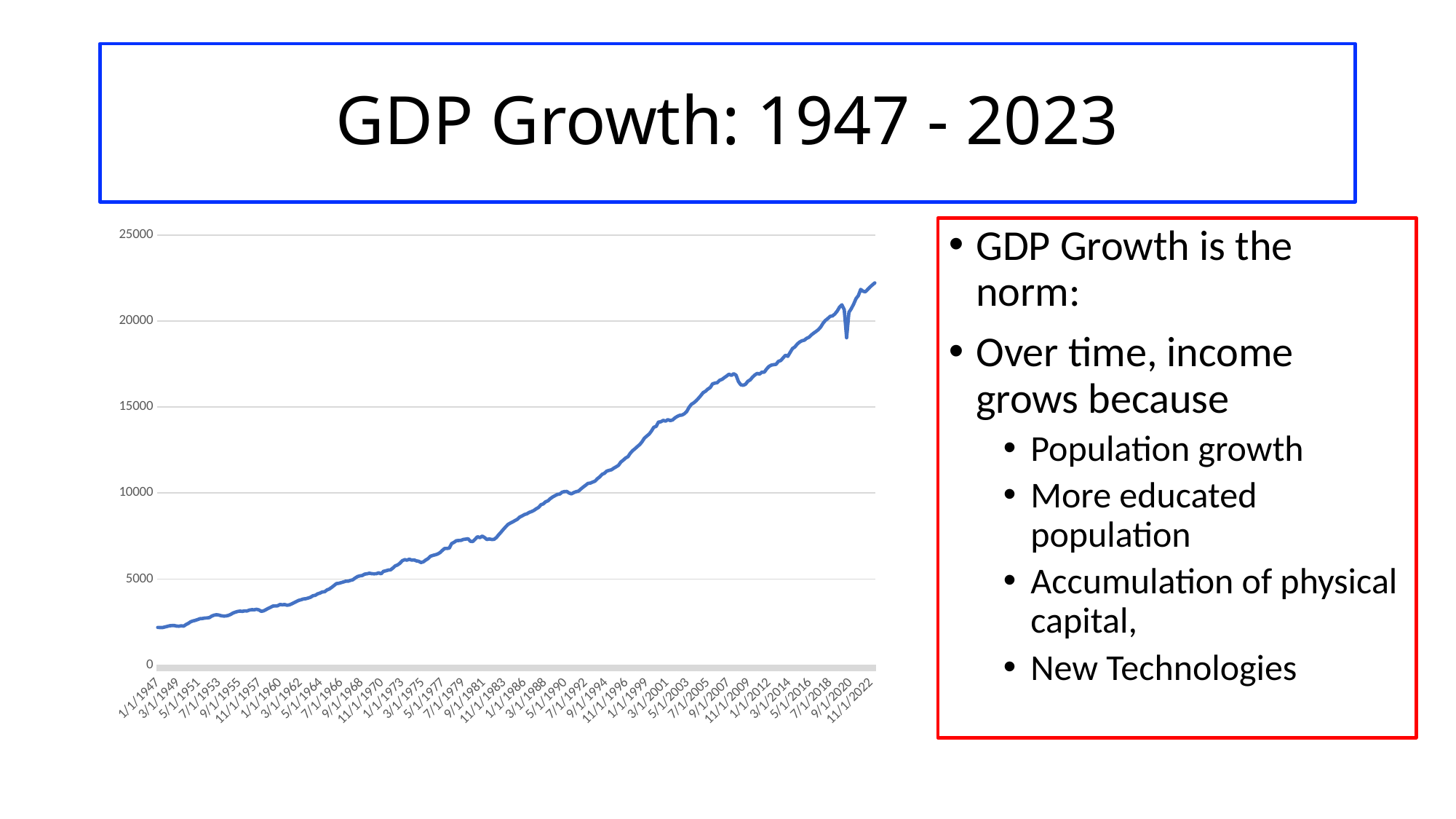
At which x-axis label is the plotted value lowest? 1/1/1947 Is the value for 9/1/1981 greater or less than 10000? less Is the value for 9/1/2007 greater or less than 15000? greater What is the highest value shown on the y axis of the chart? 25000 Is the value for 11/1/2022 greater or less than 20000? greater Do the values in the chart generally rise or fall from left to right along the x axis? rise How many lines are plotted in the chart? 1 What kind of chart is shown on the slide? line chart Which is larger, the value for 9/1/1981 or the value for 9/1/2007? 9/1/2007